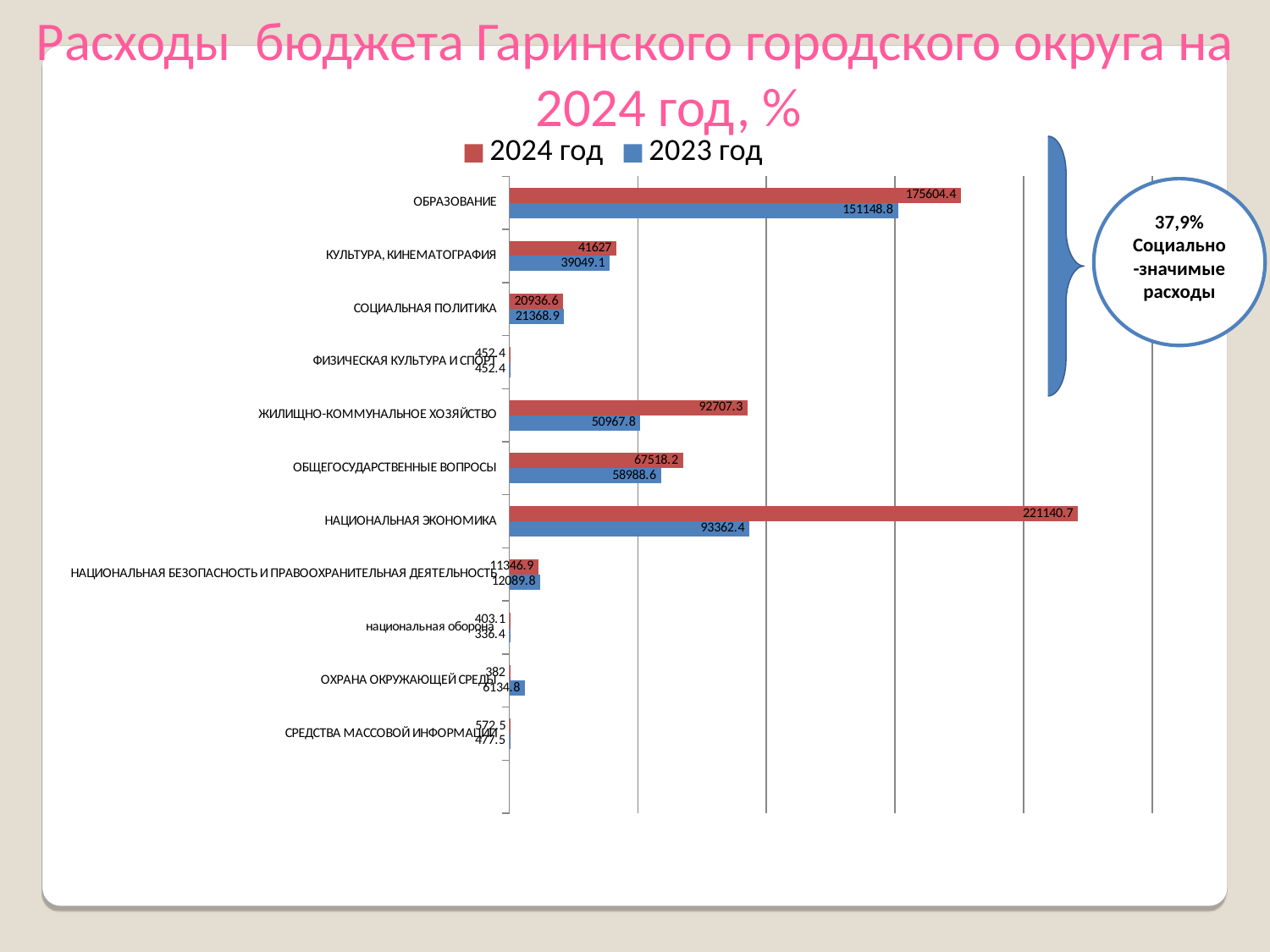
What is the difference between the 2024 год and 2023 год values for ОБРАЗОВАНИЕ? 24455.6 How many categories are shown on the chart? 11 Which category has the highest value in the 2024 год series? НАЦИОНАЛЬНАЯ ЭКОНОМИКА Which category has the highest value in the 2023 год series? ОБРАЗОВАНИЕ What is the value for ЖИЛИЩНО-КОММУНАЛЬНОЕ ХОЗЯЙСТВО in the 2023 год series? 50967.8 What is the value for ОБРАЗОВАНИЕ in the 2024 год series? 175604.4 Which category has the lowest value in the 2024 год series? ОХРАНА ОКРУЖАЮЩЕЙ СРЕДЫ What is the value for НАЦИОНАЛЬНАЯ ЭКОНОМИКА in the 2024 год series? 221140.7 What kind of chart is shown on the slide? Bar chart For СОЦИАЛЬНАЯ ПОЛИТИКА, which series has the larger value, 2024 год or 2023 год? 2023 год How many series does the legend list? 2 What is the difference between the 2024 год and 2023 год values for НАЦИОНАЛЬНАЯ ЭКОНОМИКА? 127778.3